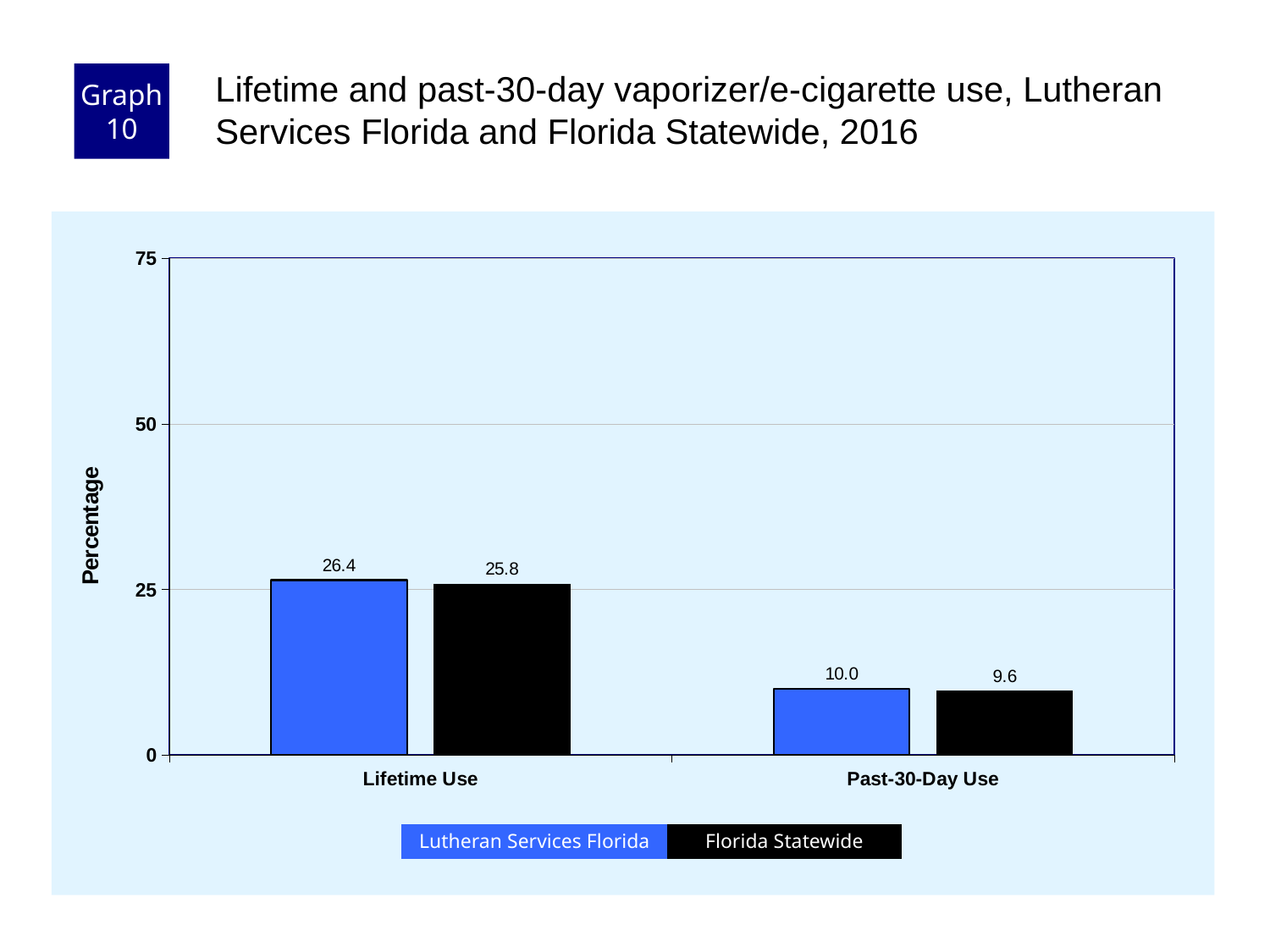
Which category has the highest Lutheran Services Florida value? Lifetime Use What is the Lutheran Services Florida value for Lifetime Use? 26.4 How many series does the legend list? 2 Which category has the lowest Florida Statewide value? Past-30-Day Use What is the difference between the Lutheran Services Florida and Florida Statewide values for Lifetime Use? 0.6 What is the Lutheran Services Florida value for Past-30-Day Use? 10.0 What is the difference between the Lutheran Services Florida values for Lifetime Use and Past-30-Day Use? 16.4 What is the Florida Statewide value for Lifetime Use? 25.8 Is the Florida Statewide value for Lifetime Use greater or less than 50? less What kind of chart is shown on the slide? bar chart How many categories are shown on the x axis? 2 What is the Florida Statewide value for Past-30-Day Use? 9.6